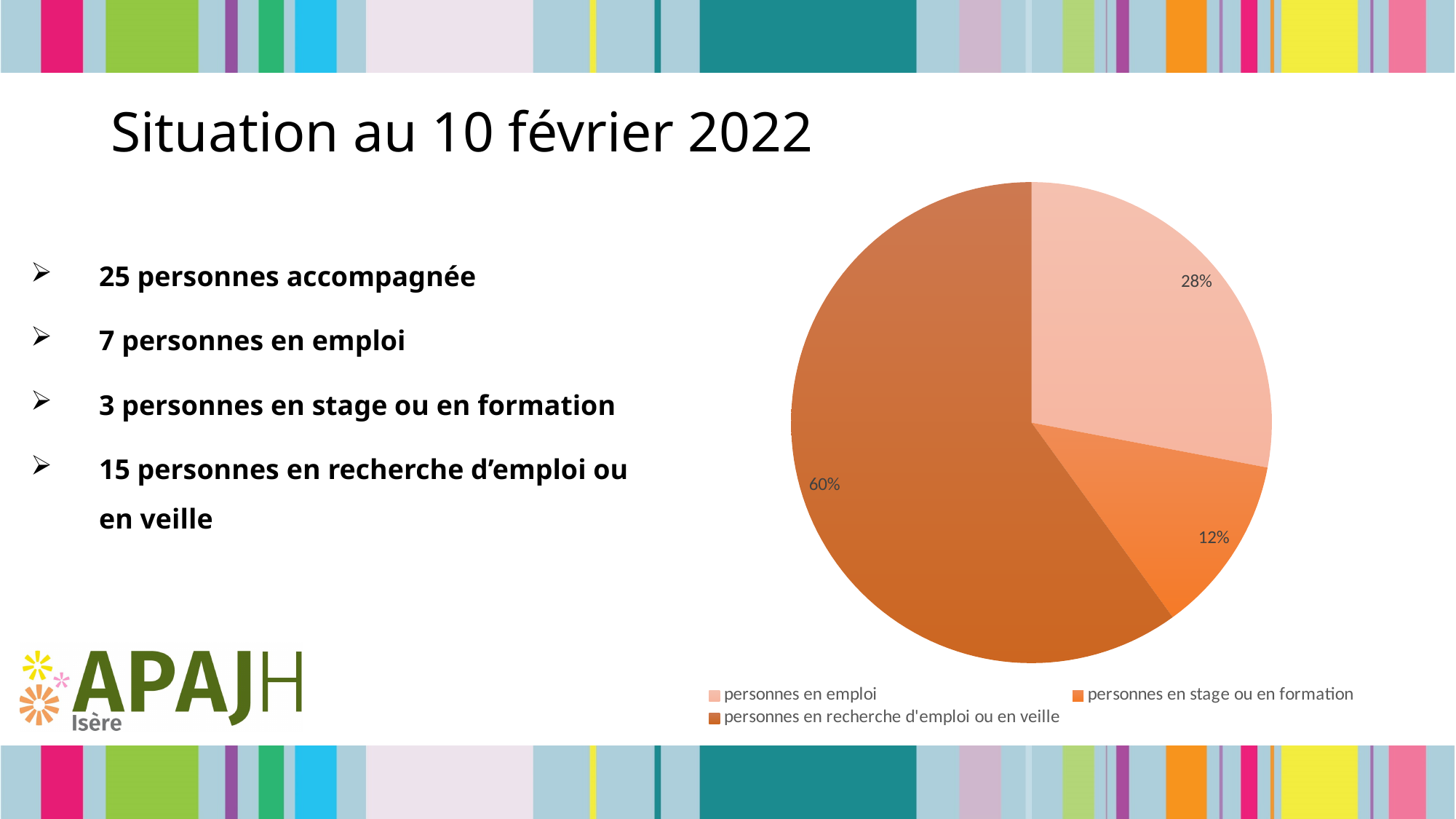
Which category has the largest slice of the pie? personnes en recherche d'emploi ou en veille What share of the pie is 'personnes en stage ou en formation'? 12% What share of the pie is 'personnes en recherche d'emploi ou en veille'? 60% What kind of chart is shown on the slide? pie chart How many slices does the pie chart have? 3 Which legend entry is shown in the lightest shade of orange? personnes en emploi What is the difference in percentage points between 'personnes en emploi' and 'personnes en stage ou en formation'? 16 What share of the pie is 'personnes en emploi'? 28% Which category has the smallest slice of the pie? personnes en stage ou en formation What is the difference in percentage points between 'personnes en recherche d'emploi ou en veille' and 'personnes en emploi'? 32 How many entries does the legend list? 3 Which is larger: the share for 'personnes en emploi' or for 'personnes en stage ou en formation'? personnes en emploi